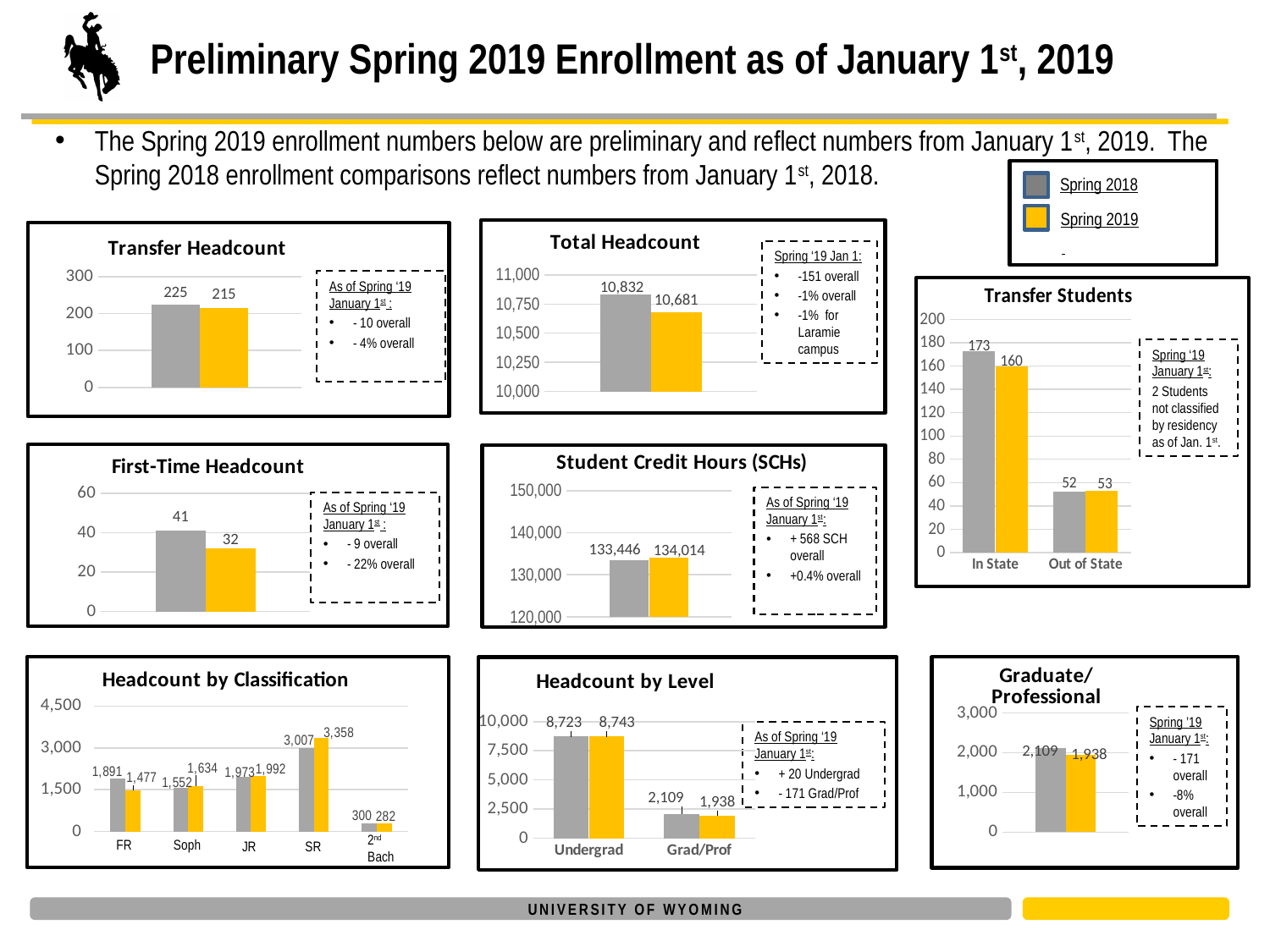
In the Student Credit Hours (SCHs) chart, what is the value for Spring 2019? 134,014 In the Headcount by Classification chart, how many classification categories are shown? 5 What type of chart is the Graduate/Professional chart? Bar chart In the First-Time Headcount chart, which is larger, the Spring 2018 value or the Spring 2019 value? Spring 2018 In the Transfer Students chart, what is the Spring 2019 value for In State? 160 In the Headcount by Classification chart, which classification has the highest Spring 2019 value? SR In the Headcount by Level chart, what is the Spring 2019 value for Grad/Prof? 1,938 In the Headcount by Level chart, what is the difference between the Spring 2018 and Spring 2019 values for Undergrad? 20 In the Headcount by Classification chart, what is the Spring 2018 value for Soph? 1,552 In the Total Headcount chart, what is the value for Spring 2018? 10,832 In the Transfer Headcount chart, what is the value for Spring 2019? 215 In the Total Headcount chart, what is the difference between the Spring 2018 and Spring 2019 values? 151